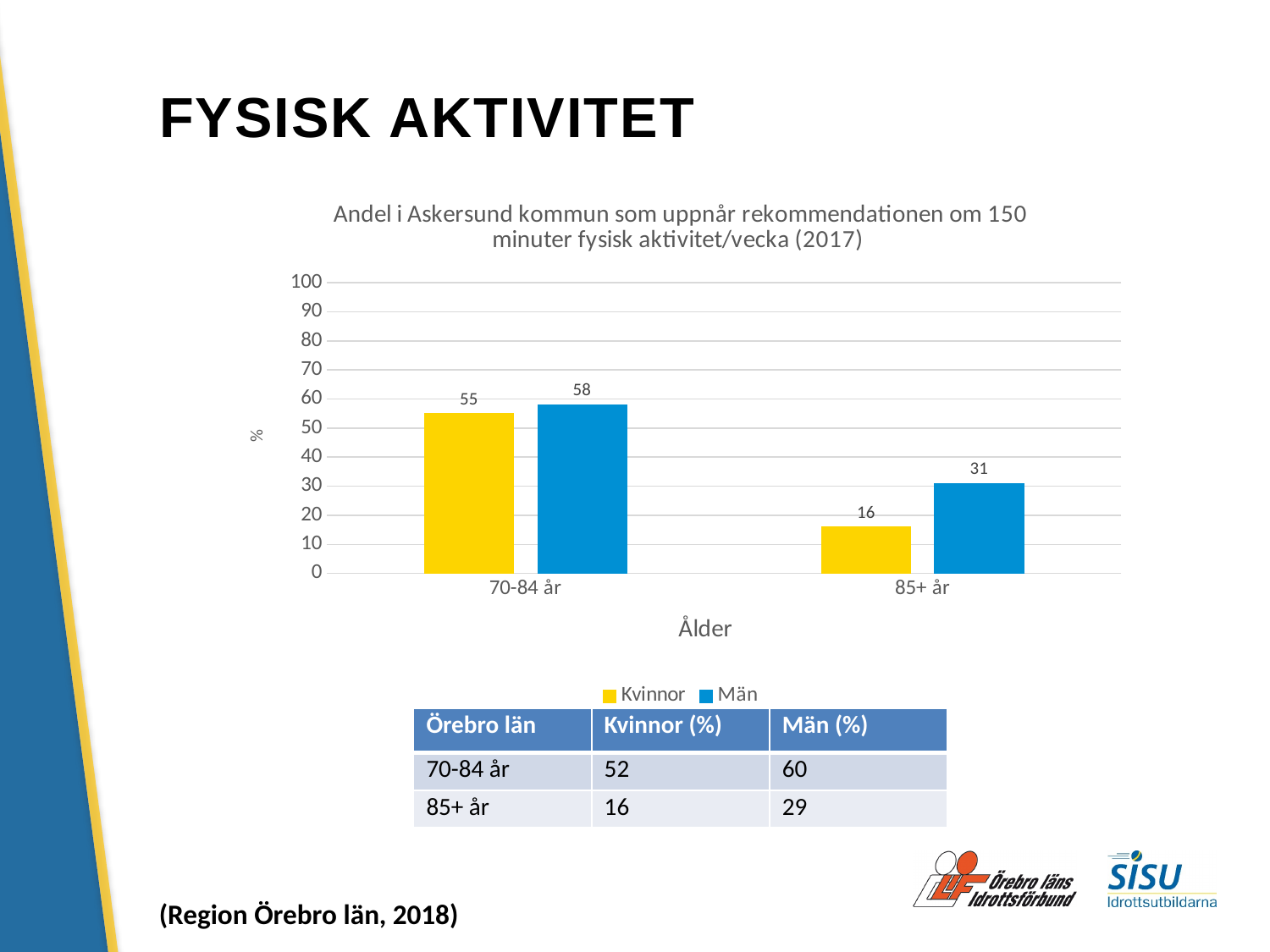
What colour represents Kvinnor in the chart? Yellow What kind of chart is shown on the slide? Bar chart How many series does the legend list? 2 What is the difference between the Män values for 70-84 år and 85+ år? 27 Which is larger in the 70-84 år age group, Kvinnor or Män? Män What is the value for Kvinnor in the 70-84 år age group? 55 How many age groups are shown on the x axis? 2 What is the value for Män in the 85+ år age group? 31 Which age group has the highest value for Män? 70-84 år What is the value for Kvinnor in the 85+ år age group? 16 Which age group has the lowest value for Kvinnor? 85+ år What is the difference between Män and Kvinnor in the 85+ år age group? 15